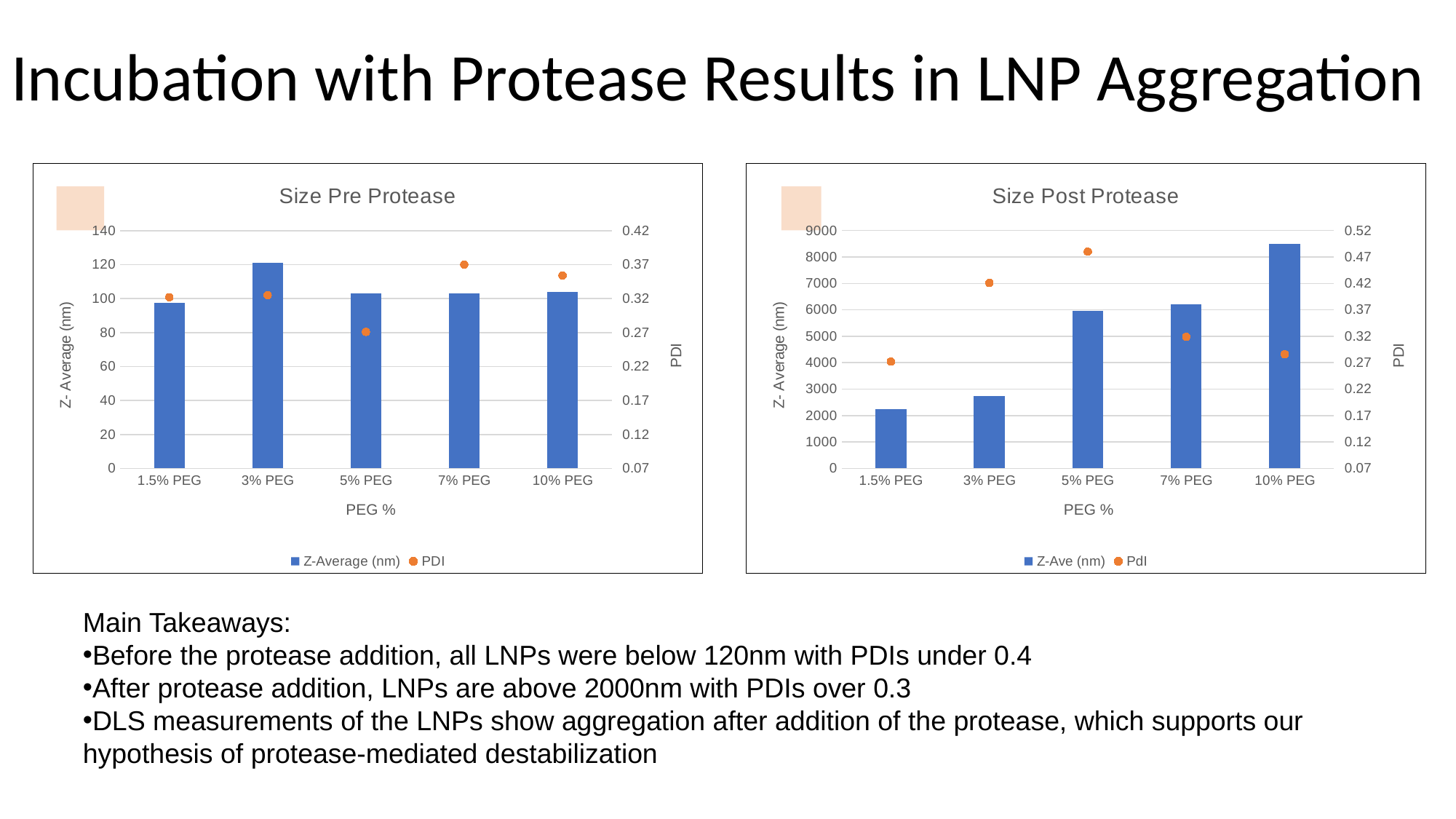
In the Size Pre Protease chart, which PEG % has the highest PDI point? 7% PEG In the Size Post Protease chart, is the Z-Ave value for 1.5% PEG greater or less than 3000? less In the Size Pre Protease chart, which PEG % has the highest Z-Average bar? 3% PEG In the Size Pre Protease chart, is the Z-Average value for 3% PEG greater or less than 100? greater In the Size Post Protease chart, which PEG % has the highest Z-Ave bar? 10% PEG How many PEG % categories are shown on the x axis of the Size Post Protease chart? 5 In the Size Pre Protease chart, which has the larger Z-Average bar, 3% PEG or 5% PEG? 3% PEG In the Size Post Protease chart, is the Z-Ave value for 10% PEG greater or less than 8000? greater How many series does the legend of the Size Pre Protease chart list? 2 In the Size Pre Protease chart, which PEG % has the lowest PDI point? 5% PEG In the Size Post Protease chart, which PEG % has the lowest Z-Ave bar? 1.5% PEG